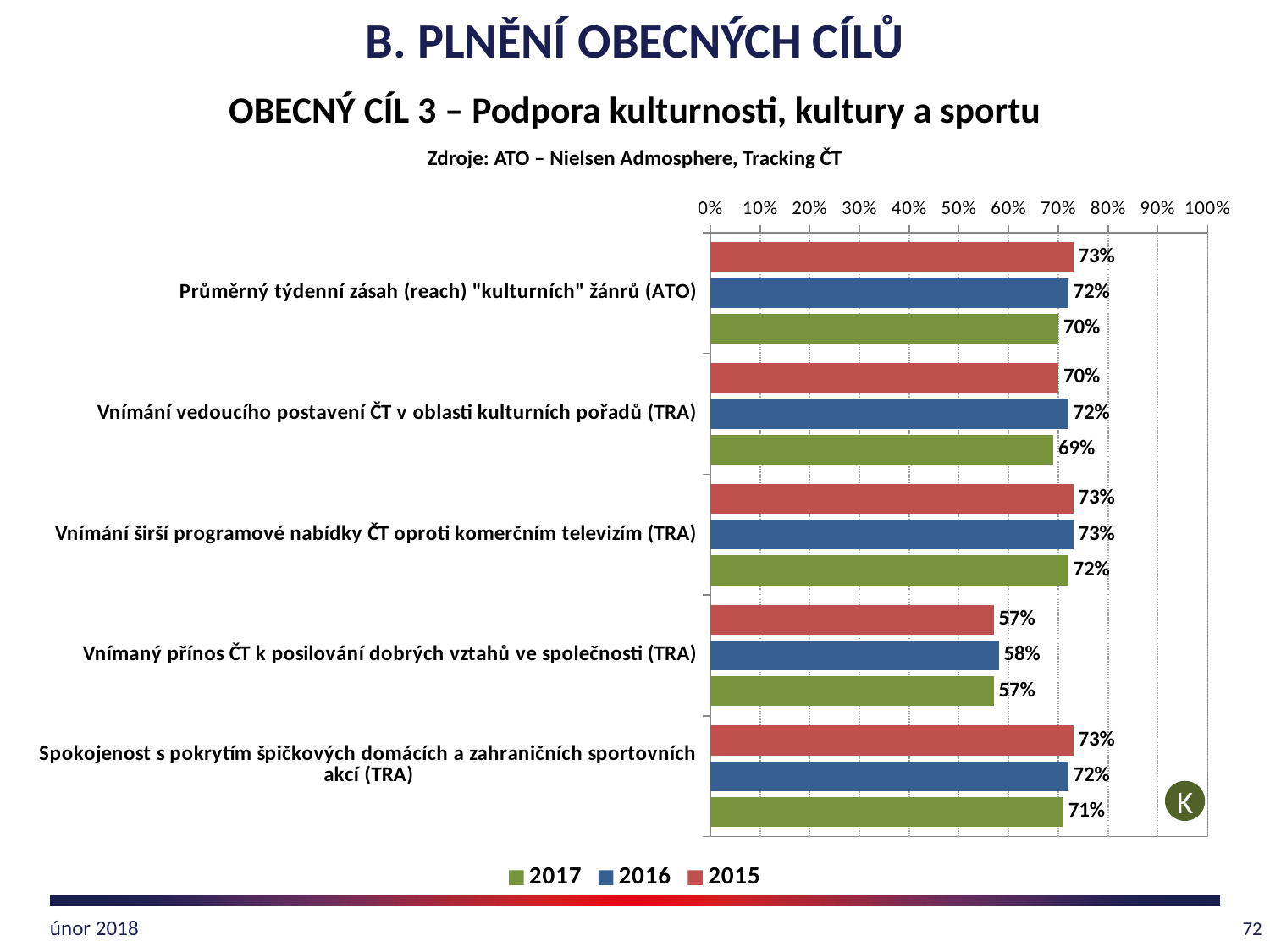
Which category has the lowest 2016 value? Vnímaný přínos ČT k posilování dobrých vztahů ve společnosti (TRA) How many categories are shown on the chart? 5 What is the difference between the 2015 and 2017 values for "Průměrný týdenní zásah (reach) "kulturních" žánrů (ATO)"? 3 percentage points What is the 2016 value for "Vnímání vedoucího postavení ČT v oblasti kulturních pořadů (TRA)"? 72% For "Vnímání vedoucího postavení ČT v oblasti kulturních pořadů (TRA)", which year has the larger value, 2016 or 2017? 2016 How many series does the legend list? 3 Which colour represents the 2015 series in the legend? Red Is the 2017 value for "Vnímaný přínos ČT k posilování dobrých vztahů ve společnosti (TRA)" greater or less than 60%? less What is the 2017 value for "Spokojenost s pokrytím špičkových domácích a zahraničních sportovních akcí (TRA)"? 71% What is the 2017 value for "Průměrný týdenní zásah (reach) "kulturních" žánrů (ATO)"? 70% What kind of chart is shown on the slide? Bar chart What is the 2015 value for "Vnímaný přínos ČT k posilování dobrých vztahů ve společnosti (TRA)"? 57%